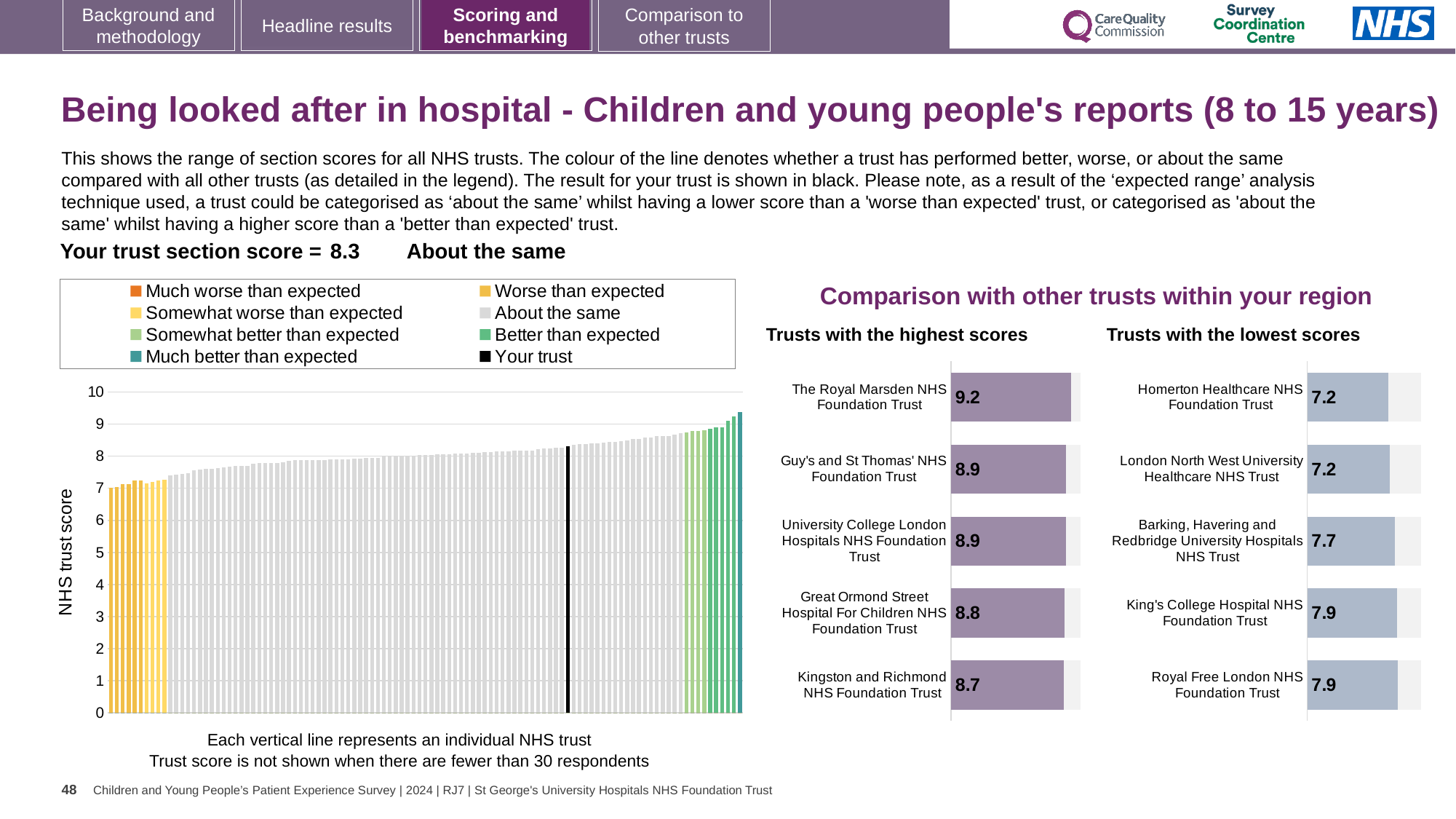
In the large chart on the left, do the trust scores rise or fall from left to right? rise How many trusts are shown in the 'Trusts with the highest scores' chart? 5 In the 'Trusts with the highest scores' chart, what is the difference between the scores of The Royal Marsden NHS Foundation Trust and Kingston and Richmond NHS Foundation Trust? 0.5 In the 'Trusts with the highest scores' chart, what is the score for Kingston and Richmond NHS Foundation Trust? 8.7 In the large chart on the left, is the value for the black 'Your trust' bar greater or less than 8? greater What kind of chart is the large chart on the left showing NHS trust scores? bar chart In the 'Trusts with the lowest scores' chart, which has the larger score: Barking, Havering and Redbridge University Hospitals NHS Trust or London North West University Healthcare NHS Trust? Barking, Havering and Redbridge University Hospitals NHS Trust In the 'Trusts with the lowest scores' chart, what is the score for Homerton Healthcare NHS Foundation Trust? 7.2 In the 'Trusts with the lowest scores' chart, what is the score for Barking, Havering and Redbridge University Hospitals NHS Trust? 7.7 In the 'Trusts with the highest scores' chart, which trust has the highest score? The Royal Marsden NHS Foundation Trust In the 'Trusts with the highest scores' chart, what is the score for The Royal Marsden NHS Foundation Trust? 9.2 In the 'Trusts with the lowest scores' chart, what is the difference between the scores of King's College Hospital NHS Foundation Trust and Homerton Healthcare NHS Foundation Trust? 0.7